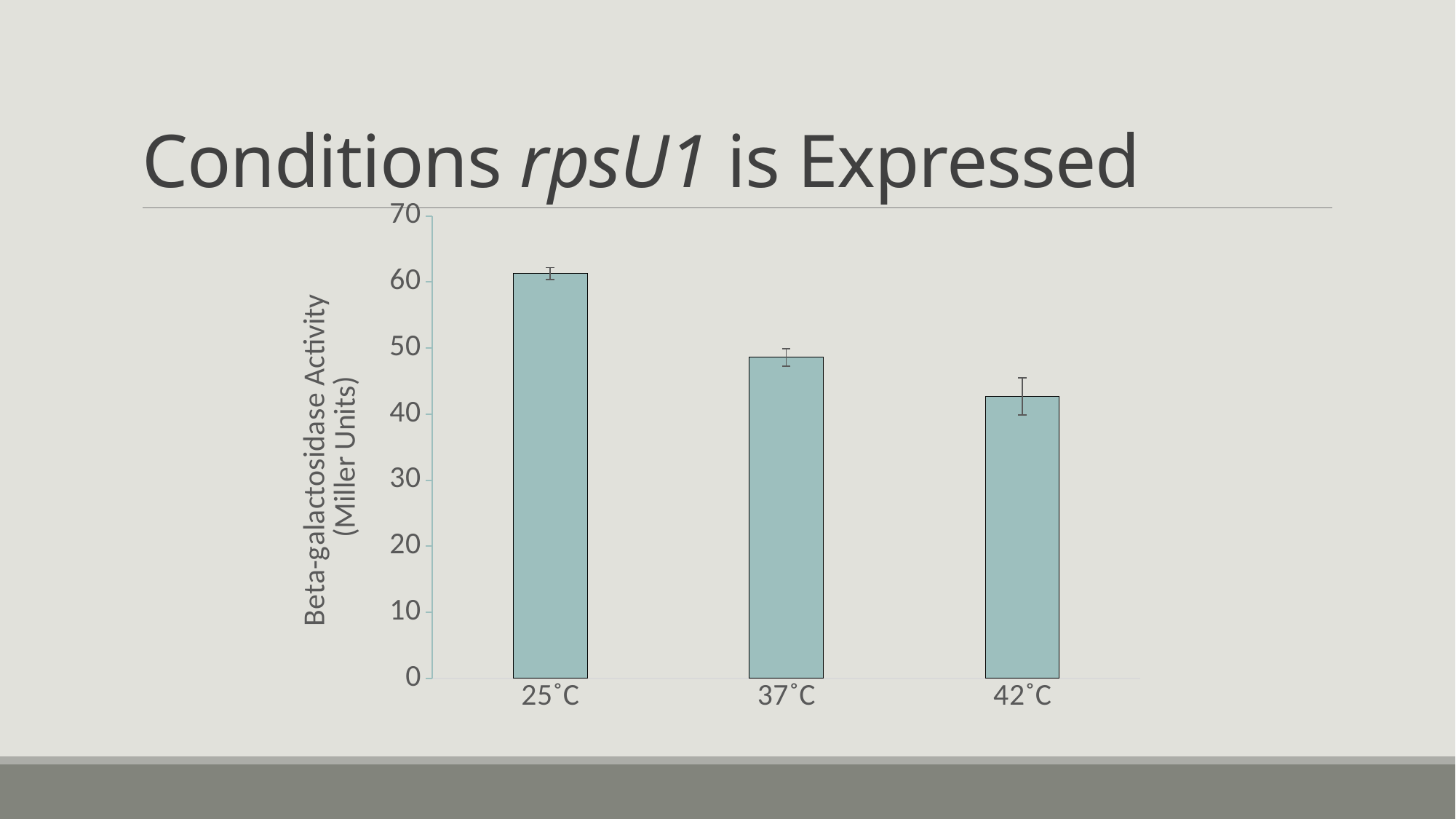
Do the values rise or fall as temperature increases along the x axis? fall What is the label of the vertical axis? Beta-galactosidase Activity (Miller Units) Is the value for 37˚C greater or less than 40? greater Which has higher beta-galactosidase activity, 25˚C or 37˚C? 25˚C How many temperature conditions are plotted in the chart? 3 What kind of chart is shown on the slide? bar chart Which has higher beta-galactosidase activity, 37˚C or 42˚C? 37˚C Is the value for 42˚C greater or less than 50? less Which temperature condition has the highest beta-galactosidase activity? 25˚C Which temperature condition has the lowest beta-galactosidase activity? 42˚C Is the value for 25˚C greater or less than 50? greater